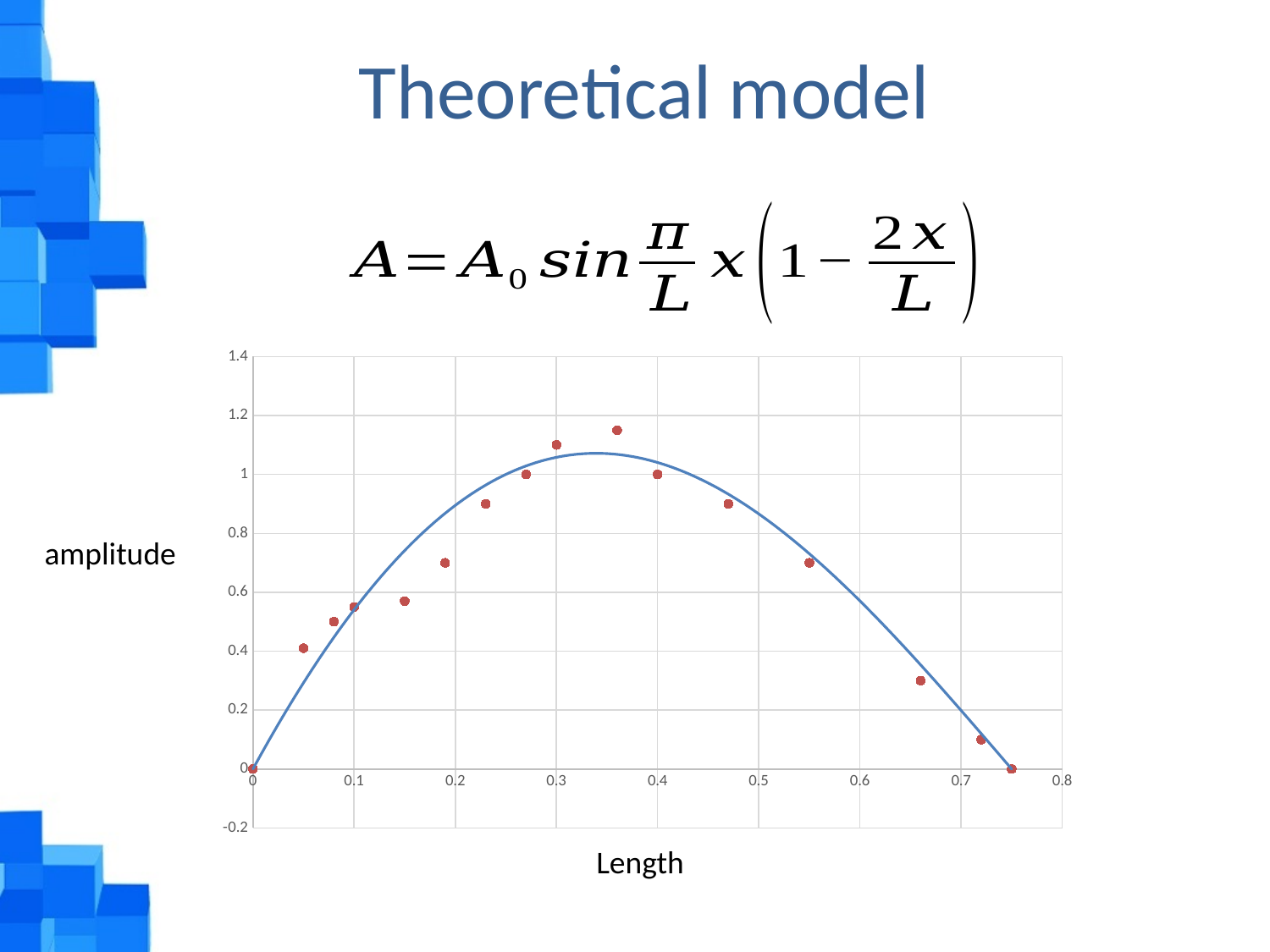
Is the amplitude of the data point at length 0.3 greater or less than 1? greater What is the amplitude of the data point at length 0.75? 0 How does the amplitude change as length increases from 0 to 0.75? it rises and then falls What is the label of the x axis of the chart? Length Is the amplitude of the data point at length 0.55 greater or less than 0.6? greater Is the amplitude of the data point at length 0.05 greater or less than 0.2? greater What kind of chart is shown on the slide? scatter chart What is the label of the y axis of the chart? amplitude